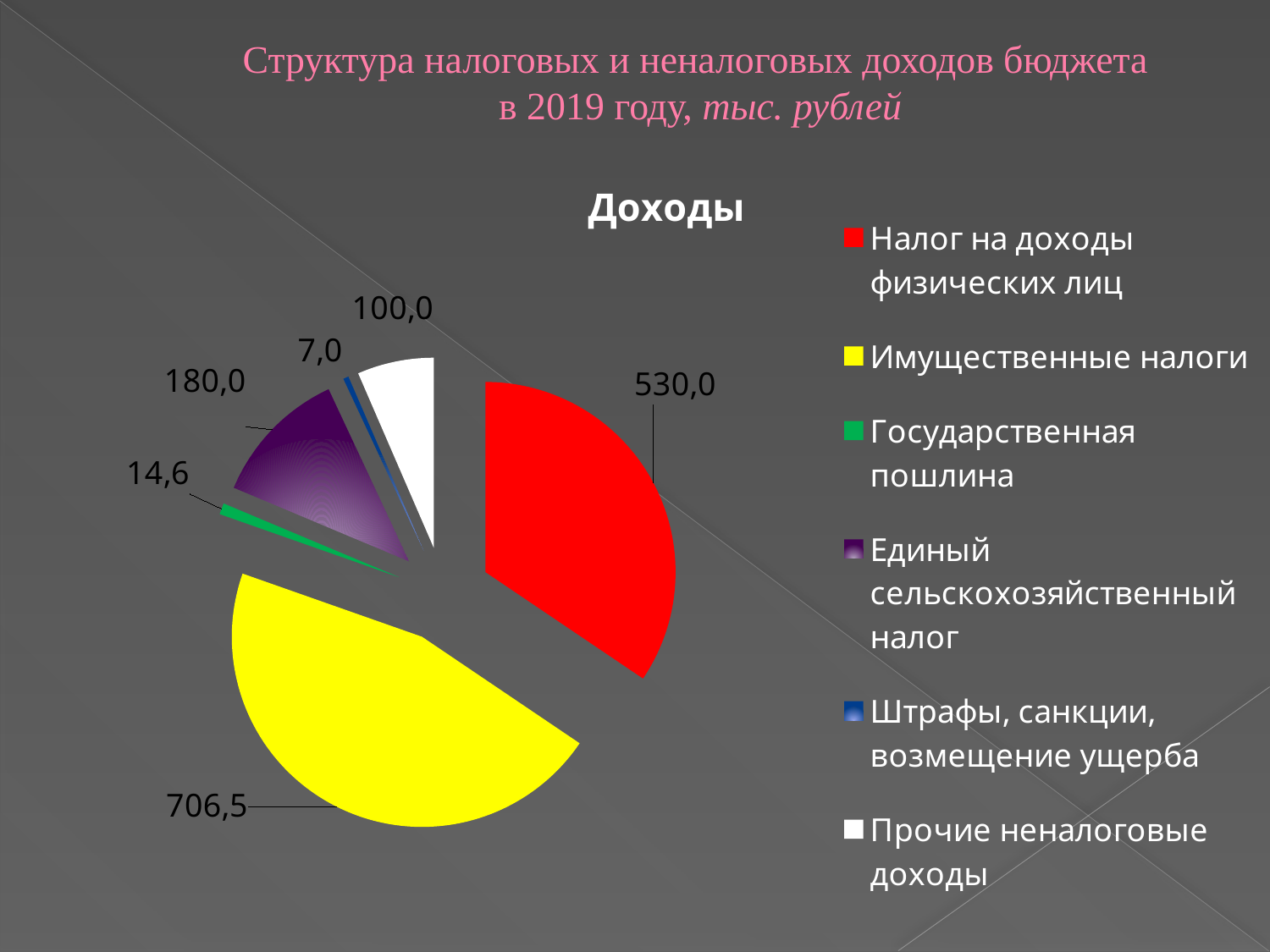
Which is larger: Государственная пошлина or Прочие неналоговые доходы? Прочие неналоговые доходы What is the value for Имущественные налоги? 706,5 What type of chart is shown on the slide? pie chart What is the difference between the values for Имущественные налоги and Налог на доходы физических лиц? 176,5 What is the difference between the values for Единый сельскохозяйственный налог and Прочие неналоговые доходы? 80,0 How many categories does the pie chart have? 6 What is the title of the pie chart? Доходы Which category has the smallest slice of the pie? Штрафы, санкции, возмещение ущерба What is the value for Налог на доходы физических лиц? 530,0 Which category has the largest slice of the pie? Имущественные налоги What is the value for Единый сельскохозяйственный налог? 180,0 What is the value for Штрафы, санкции, возмещение ущерба? 7,0